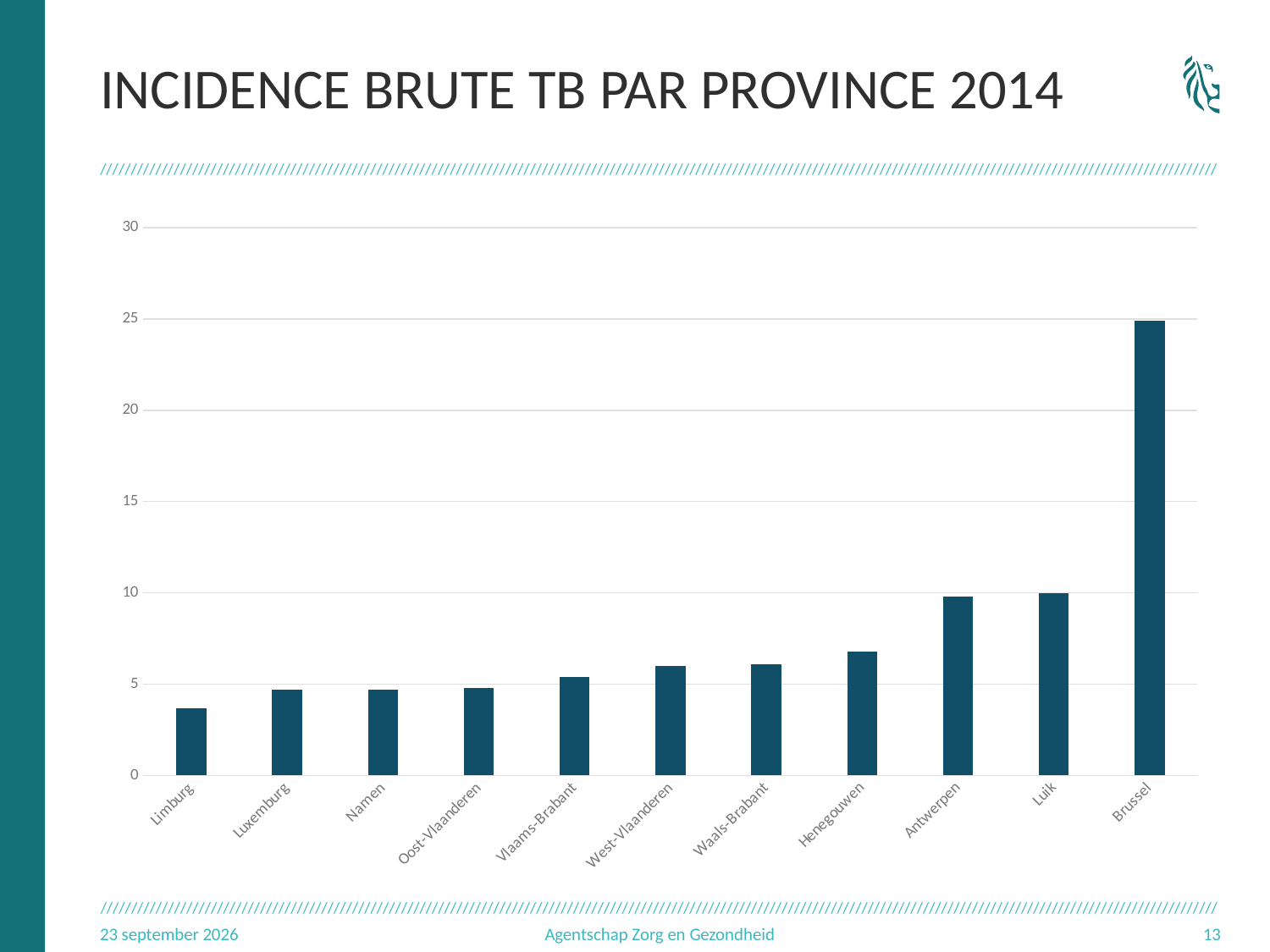
How many provinces are shown on the x axis? 11 What kind of chart is shown on the slide? bar chart Do the values generally rise or fall from left to right along the x axis? rise Is the value for Henegouwen greater or less than 5? greater What is the title of the slide containing the chart? INCIDENCE BRUTE TB PAR PROVINCE 2014 Is the value for Brussel greater or less than 20? greater Which has a higher value, Henegouwen or Limburg? Henegouwen Is the value for Limburg greater or less than 5? less Which has a higher value, Brussel or Luik? Brussel Which province has the lowest TB incidence in the chart? Limburg Which province has the highest TB incidence in the chart? Brussel